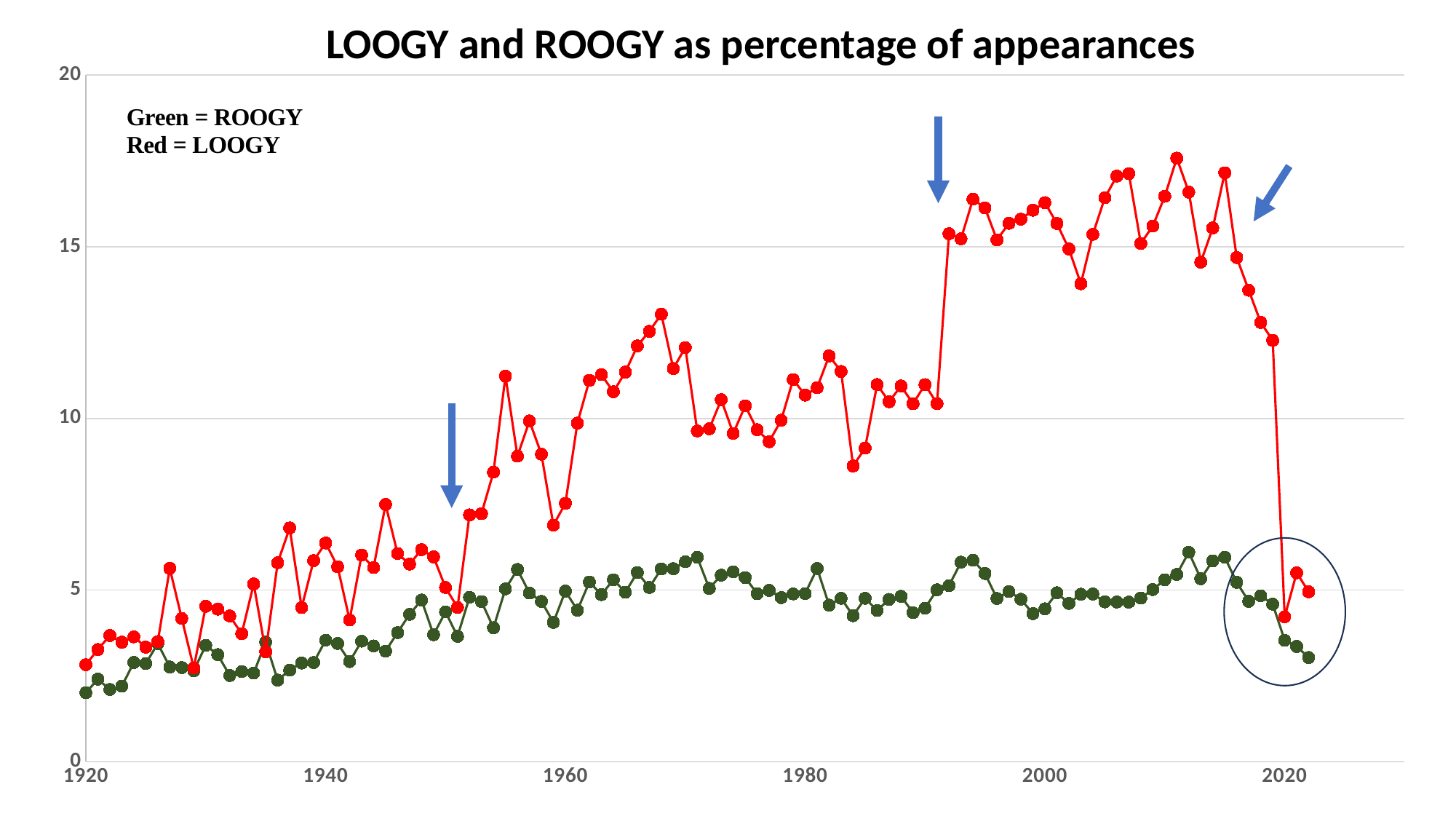
Is the ROOGY (green) value in 2000 greater or less than 5? less Does the LOOGY (red) line rise or fall between 2015 and 2020? fall Is the LOOGY (red) value in 1960 greater or less than 10? less What kind of chart is shown on the slide? line chart What is the title of the chart? LOOGY and ROOGY as percentage of appearances How many data series are plotted on the chart? 2 Is the ROOGY (green) value in 1920 greater or less than 5? less In 2000, which series has the higher value, LOOGY or ROOGY? LOOGY Which series reaches the highest value anywhere on the chart? LOOGY Which series is drawn in green? ROOGY